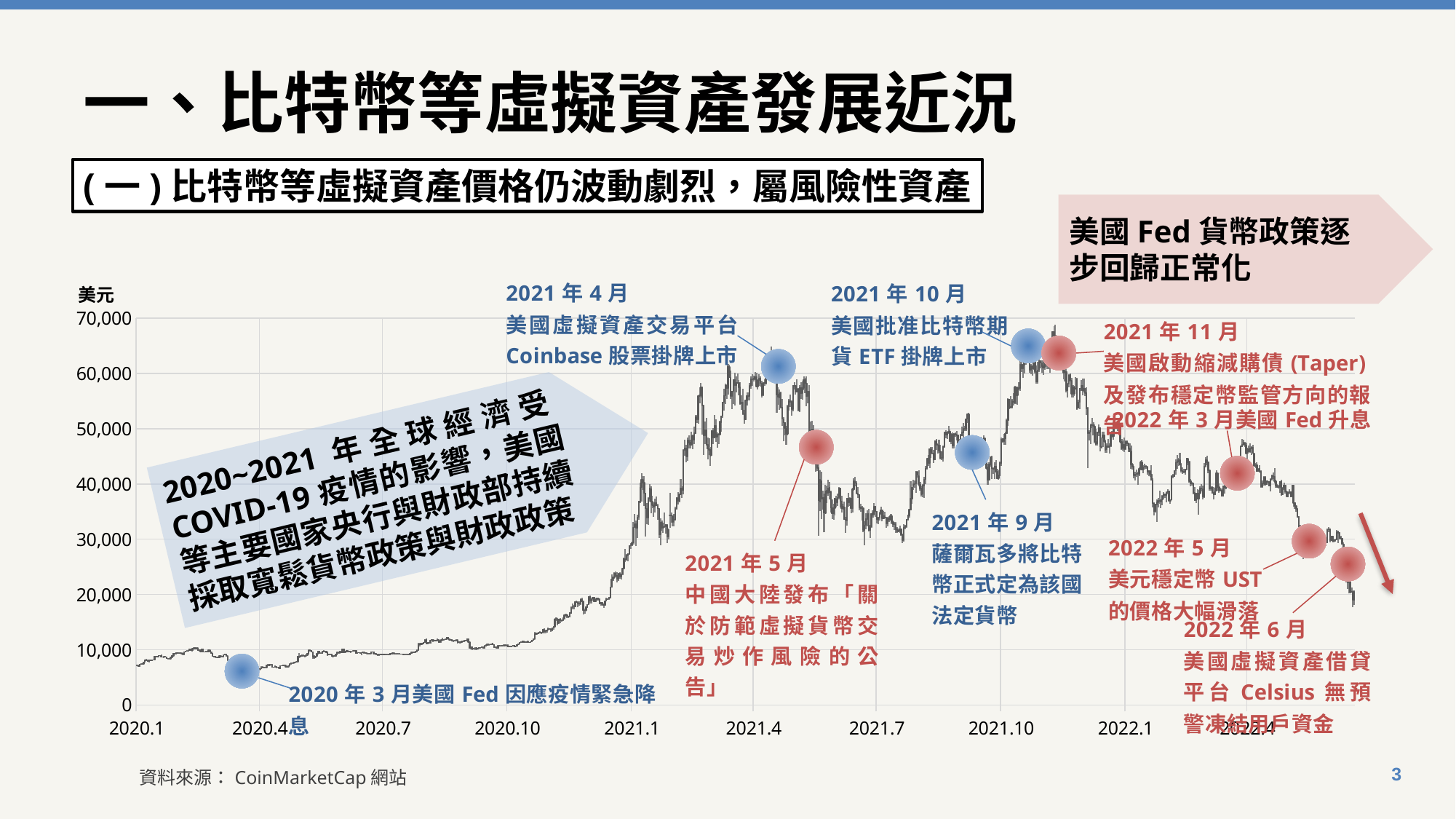
How many tick labels are shown on the horizontal axis? 10 Is the value at 2020.10 greater or less than 20,000? less What unit label is shown at the top of the vertical axis? 美元 Is the value at 2021.4 greater or less than 50,000? greater Is the value at 2020.7 greater or less than 20,000? less What is the highest value labelled on the vertical axis? 70,000 Does the line generally rise or fall between 2021.10 and the end of the series? fall Does the line generally rise or fall between 2020.1 and 2021.4? rise What kind of chart is shown on the slide? line chart